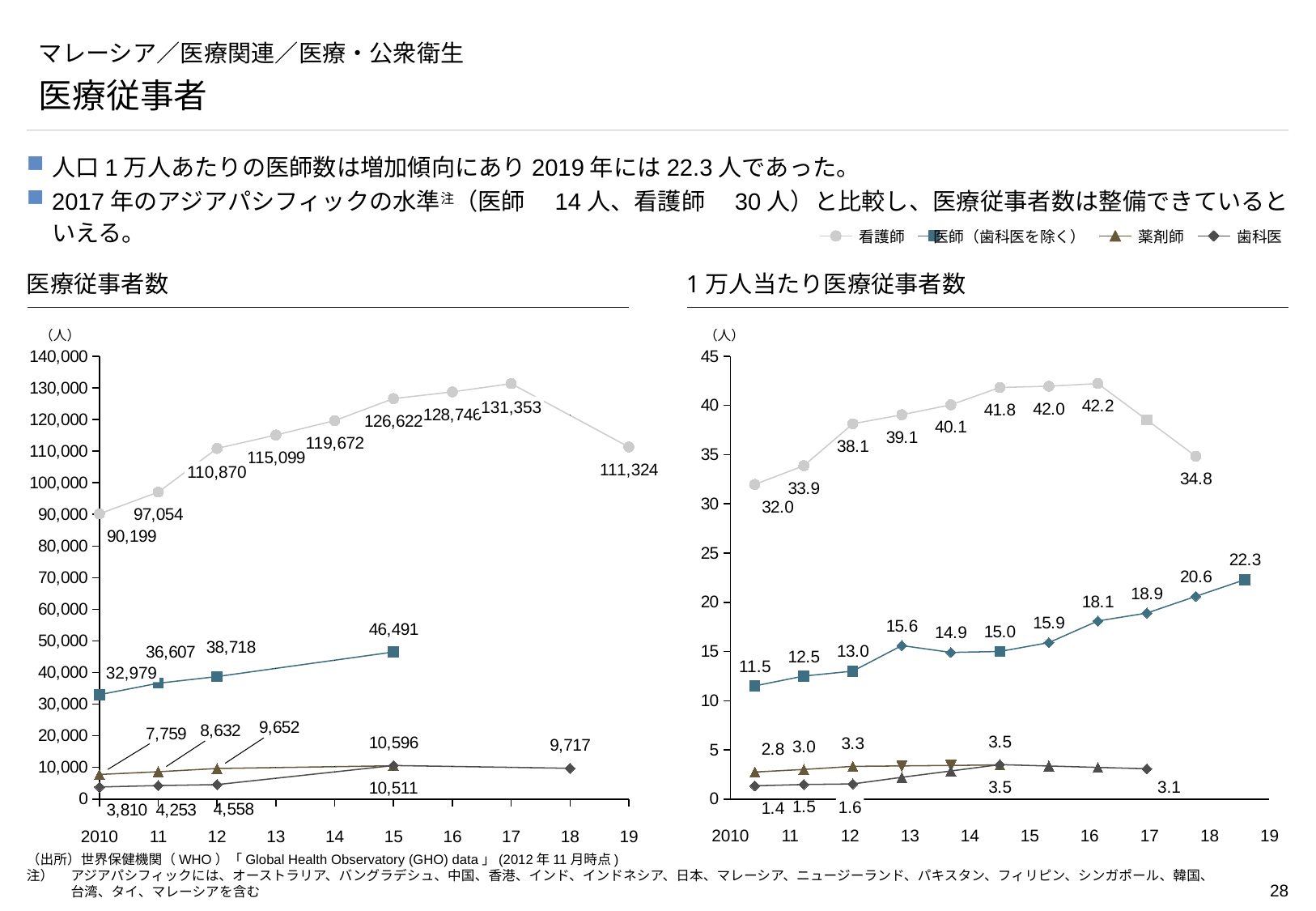
What type of chart is used on this slide for 医療従事者数 and 1万人当たり医療従事者数? Line chart In the 1万人当たり医療従事者数 chart, is the value for 看護師 in 2017 greater or less than 35? greater In the 医療従事者数 chart, what is the difference between the 看護師 values in 2017 and 2019? 20,029 In the 1万人当たり医療従事者数 chart, does the 医師（歯科医を除く） series generally rise or fall from 2010 to 2019? rise In the 医療従事者数 chart, what is the value for 医師（歯科医を除く） in 2010? 32,979 How many series does the legend list? 4 In the 医療従事者数 chart, which is larger in 2012: 看護師 or 医師（歯科医を除く）? 看護師 In the 1万人当たり医療従事者数 chart, what is the value for 看護師 in 2010? 32.0 In the 医療従事者数 chart, what is the value for 看護師 in 2017? 131,353 In the 1万人当たり医療従事者数 chart, what is the value for 医師（歯科医を除く） in 2019? 22.3 In the 医療従事者数 chart, in which year is the 看護師 value highest? 2017 In the 1万人当たり医療従事者数 chart, what is the difference between the 医師（歯科医を除く） values in 2019 and 2010? 10.8